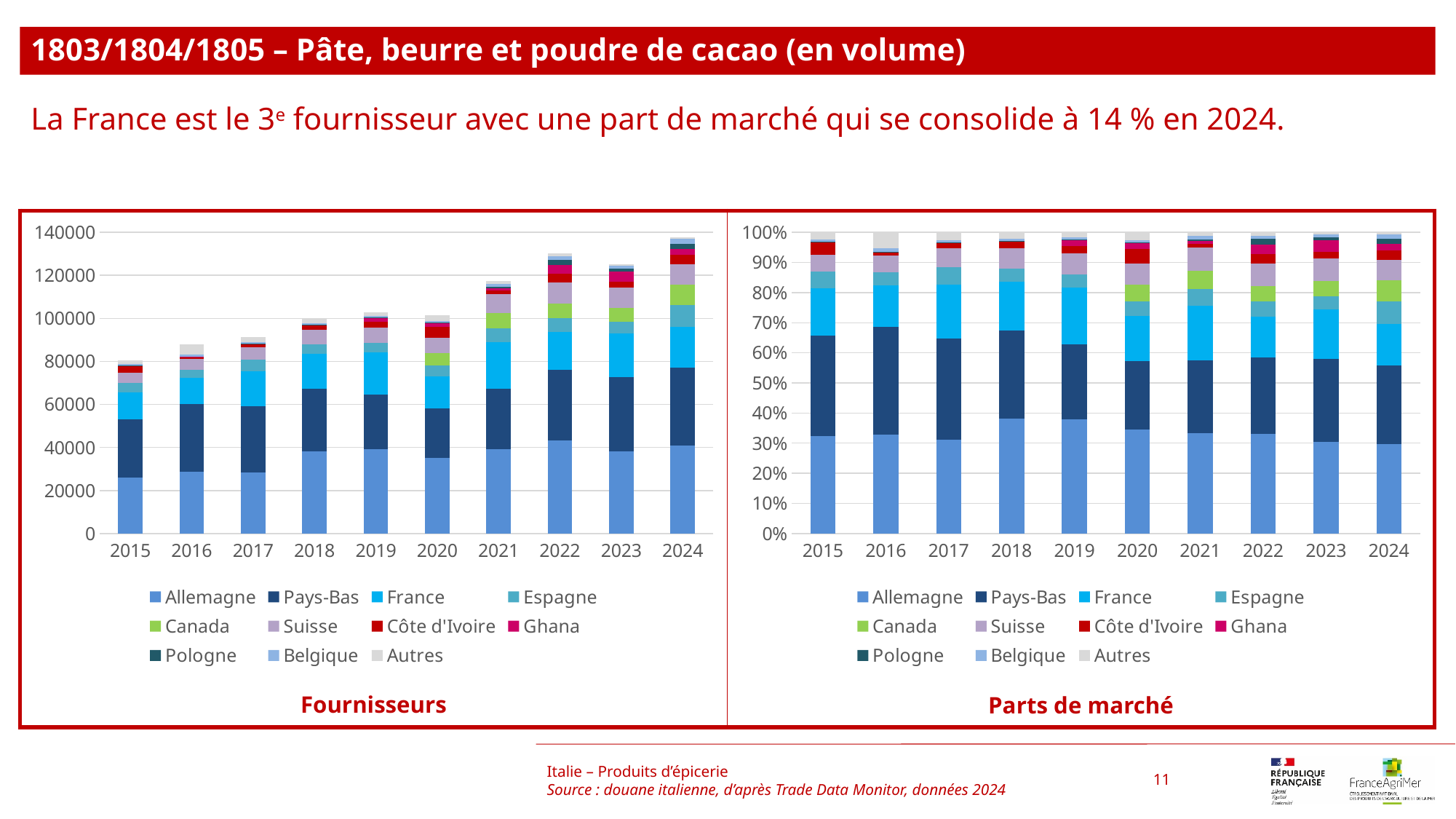
In the 'Fournisseurs' chart, which year has the larger total bar, 2021 or 2024? 2024 In the 'Parts de marché' chart, is the share of Allemagne in 2018 greater or less than 30%? greater How many years are shown on the x axis of the 'Parts de marché' chart? 10 How many series does the legend of the 'Fournisseurs' chart list? 11 What is the title of the chart on the right side of the slide? Parts de marché What kind of chart is the 'Fournisseurs' chart on the left? Stacked bar chart In the 'Fournisseurs' chart, do the total bars generally rise or fall from 2015 to 2024? rise In the 'Fournisseurs' chart, which year has the lowest total bar? 2015 In the 'Fournisseurs' chart, is the total for 2016 greater or less than 100000? less Which series is listed first in the legend of the 'Parts de marché' chart? Allemagne In the 'Fournisseurs' chart, which year has the highest total bar? 2024 In the 'Fournisseurs' chart, is the total for 2024 greater or less than 120000? greater